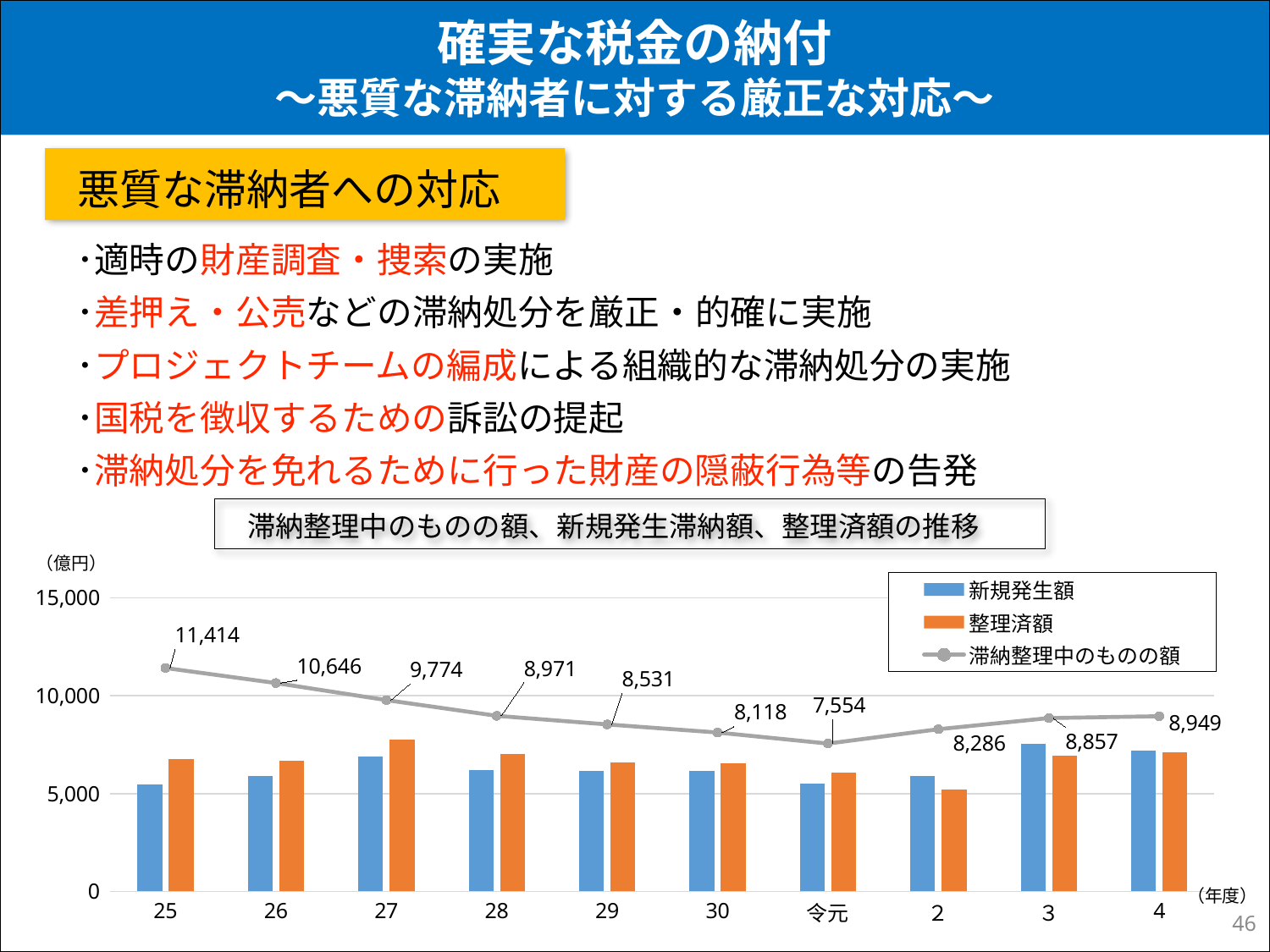
In which fiscal year is 滞納整理中のものの額 the lowest? 令元 How many series does the chart legend list? 3 What is the value of 滞納整理中のものの額 for 令元? 7,554 How many fiscal years are shown on the x axis of the chart? 10 Does 滞納整理中のものの額 rise or fall from fiscal year 25 to 令元? fall Is the value of 新規発生額 for fiscal year 25 greater or less than 5,000? greater What is the difference between 滞納整理中のものの額 in fiscal year 26 and fiscal year 27? 872 Which is larger, 滞納整理中のものの額 in fiscal year 28 or in fiscal year 2? 28 In which fiscal year is 滞納整理中のものの額 the highest? 25 What is the value of 滞納整理中のものの額 for fiscal year 25? 11,414 What is the value of 滞納整理中のものの額 for fiscal year 4? 8,949 What is the difference between 滞納整理中のものの額 in fiscal year 25 and fiscal year 4? 2,465